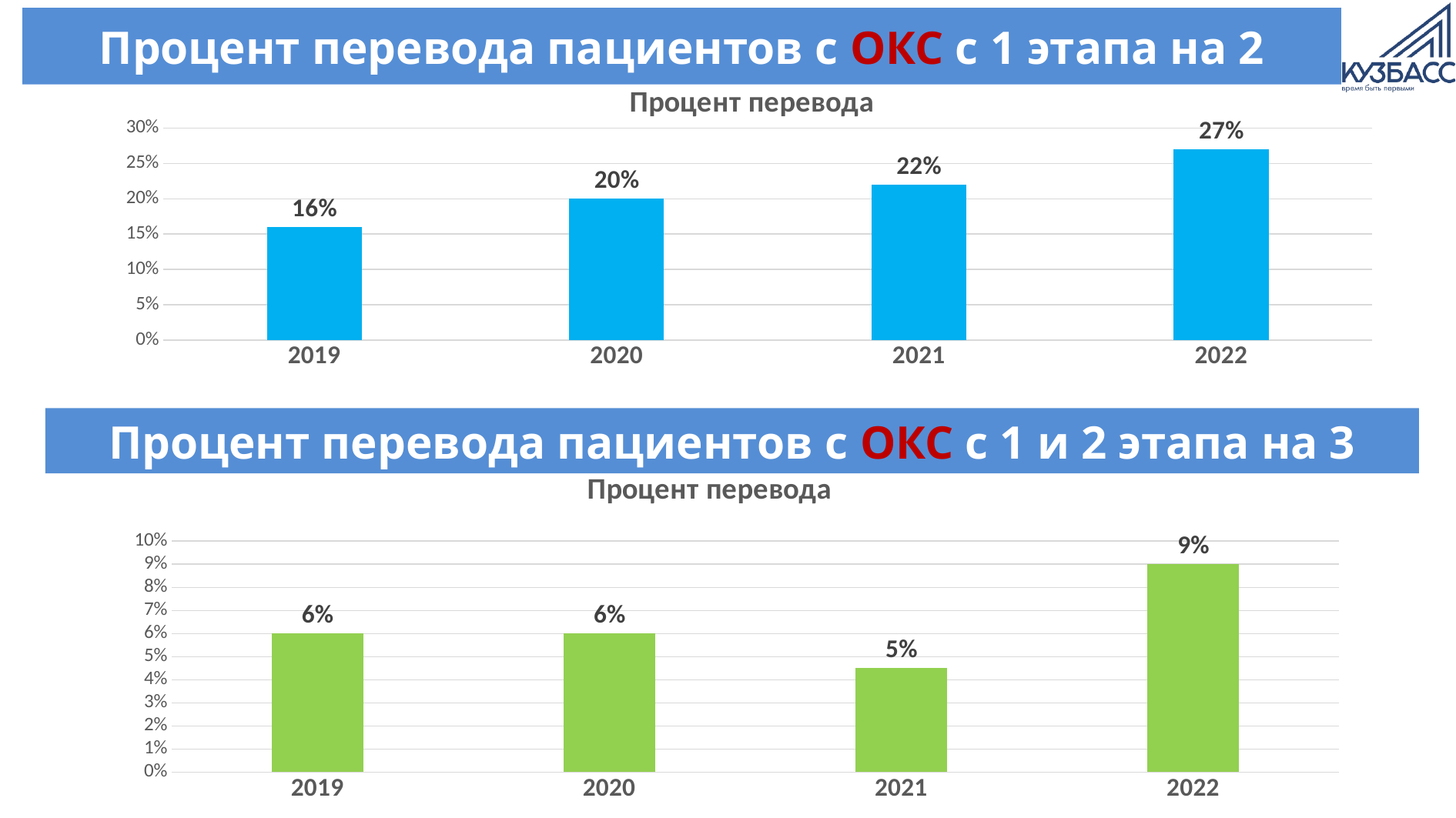
In the bottom chart (Процент перевода пациентов с ОКС с 1 и 2 этапа на 3), which year has the highest value? 2022 In the top chart (Процент перевода пациентов с ОКС с 1 этапа на 2), what is the value for 2022? 27% In the top chart (Процент перевода пациентов с ОКС с 1 этапа на 2), which year has the lowest value? 2019 In the top chart (Процент перевода пациентов с ОКС с 1 этапа на 2), which year has the highest value? 2022 In the bottom chart (Процент перевода пациентов с ОКС с 1 и 2 этапа на 3), how many years are shown on the x axis? 4 In the bottom chart (Процент перевода пациентов с ОКС с 1 и 2 этапа на 3), what is the difference between the values for 2022 and 2019? 3% In the top chart (Процент перевода пациентов с ОКС с 1 этапа на 2), do the values rise or fall from 2019 to 2022? rise In the top chart (Процент перевода пациентов с ОКС с 1 этапа на 2), what is the value for 2019? 16% In the bottom chart (Процент перевода пациентов с ОКС с 1 и 2 этапа на 3), what is the value for 2022? 9% In the top chart (Процент перевода пациентов с ОКС с 1 этапа на 2), what is the difference between the values for 2022 and 2019? 11% What kind of chart is the top chart (Процент перевода пациентов с ОКС с 1 этапа на 2)? bar chart In the bottom chart (Процент перевода пациентов с ОКС с 1 и 2 этапа на 3), what is the value for 2021? 5%